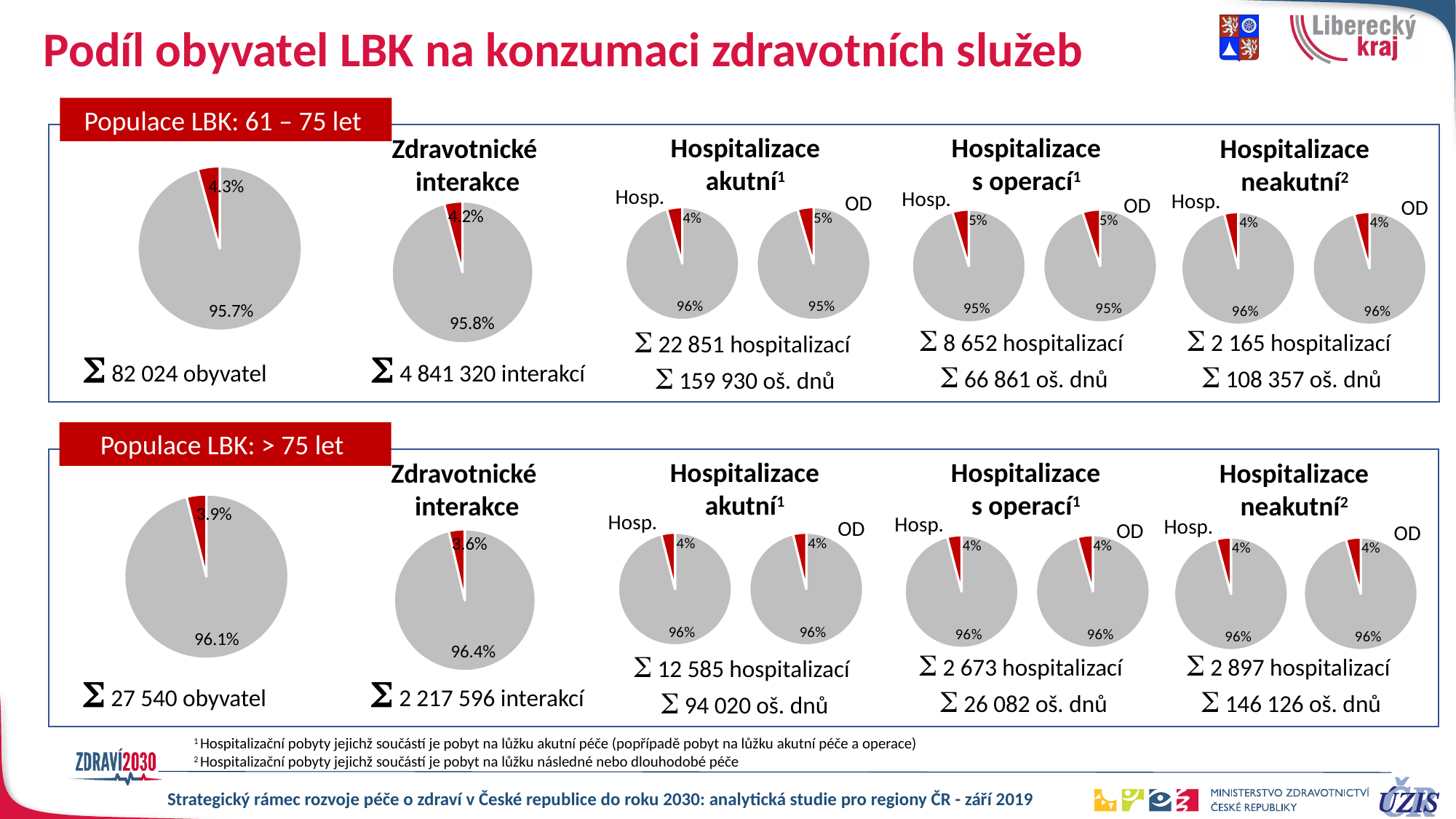
In the 'Hospitalizace s operací' Hosp. pie chart for the 61 – 75 let population, what is the value of the grey slice? 95% How many slices does each pie chart on the slide have? 2 What kind of charts are shown on the slide? Pie charts In the population pie chart for 'Populace LBK: 61 – 75 let', what share does the grey slice represent? 95.7% In the population pie chart for 'Populace LBK: > 75 let', what share does the red slice represent? 3.9% In the population pie chart for 'Populace LBK: 61 – 75 let', what share does the red slice represent? 4.3% What total number of inhabitants is shown under the population pie chart for 'Populace LBK: > 75 let'? 27 540 obyvatel Which is larger: the red slice in the 61 – 75 let population pie chart (4.3%) or the red slice in the > 75 let population pie chart (3.9%)? 61 – 75 let (4.3%) In the 'Zdravotnické interakce' pie chart for the 61 – 75 let population, what is the value of the red slice? 4.2% In the 'Hospitalizace akutní' OD pie chart for the 61 – 75 let population, what is the value of the red slice? 5% In the population pie chart for 'Populace LBK: 61 – 75 let', what is the difference in percentage points between the grey slice and the red slice? 91.4 In the 'Zdravotnické interakce' pie chart for the > 75 let population, what is the value of the grey slice? 96.4%